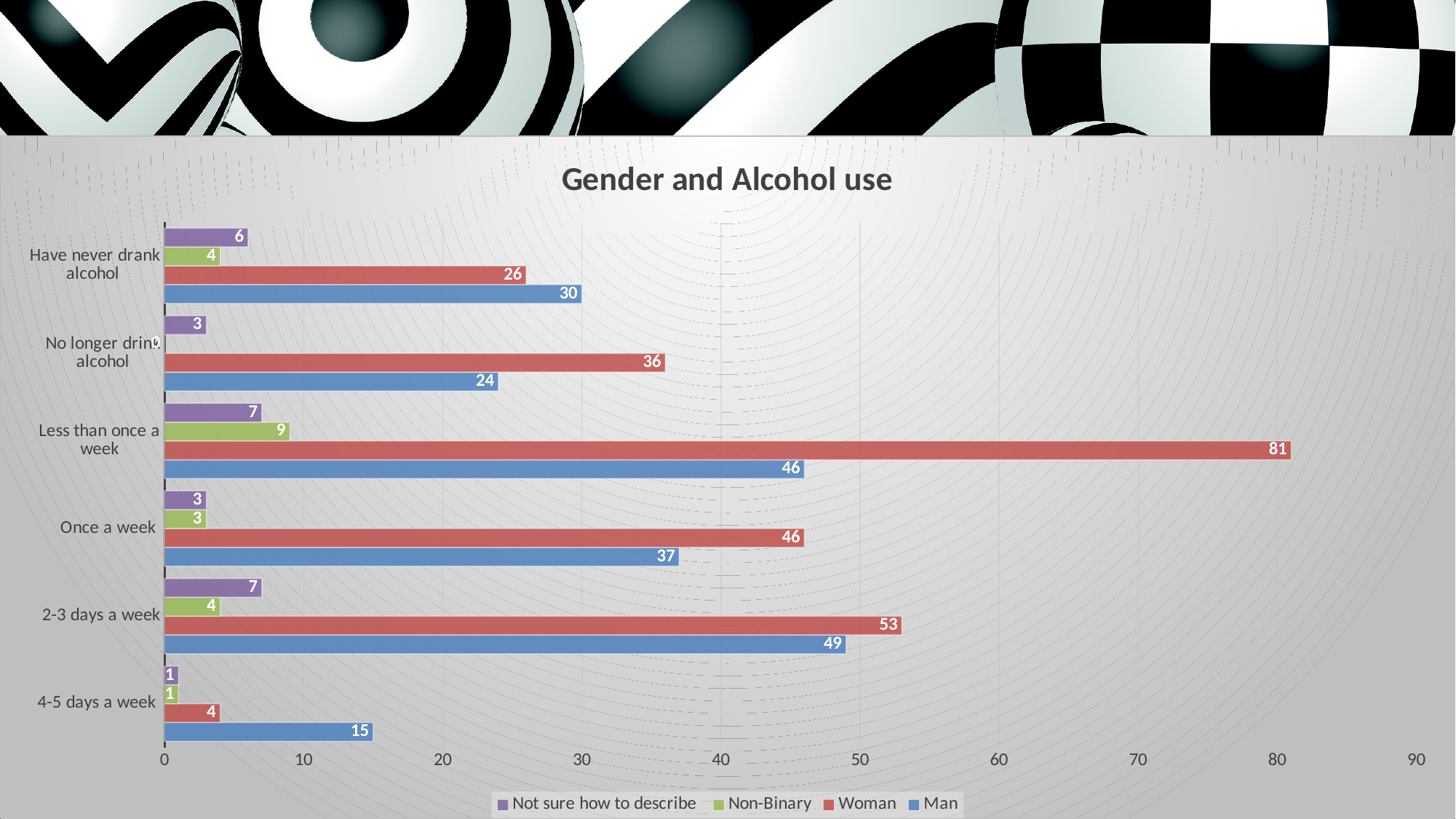
Is the value for Man in the '2-3 days a week' category greater or less than 40? greater In the 'No longer drink alcohol' category, which is larger, the value for Woman or the value for Man? Woman What is the value for Man in the '4-5 days a week' category? 15 How many categories are shown on the chart? 6 What kind of chart is shown on the slide? Bar chart Which category has the highest value for Woman? Less than once a week What is the value for Woman in the 'Less than once a week' category? 81 What is the value for Non-Binary in the 'Less than once a week' category? 9 What is the difference between the Woman and Man values in the 'Less than once a week' category? 35 Which category has the lowest value for Man? 4-5 days a week How many series does the legend list? 4 What is the title of the chart? Gender and Alcohol use